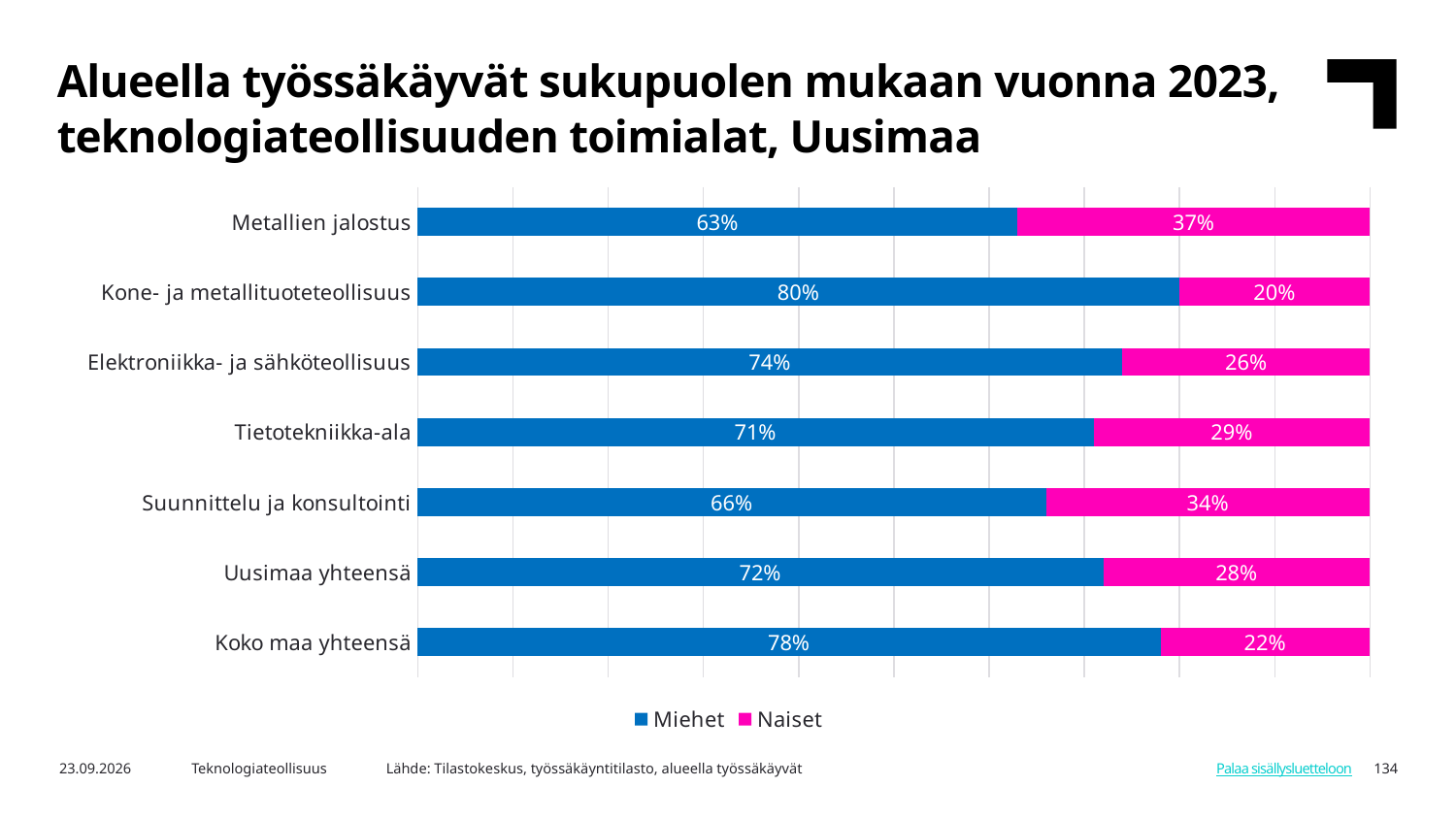
What is the Naiset share for Uusimaa yhteensä? 28% Which category has the highest Naiset share? Metallien jalostus How many categories are shown on the chart? 7 What is the Miehet share for Kone- ja metallituoteteollisuus? 80% How many series does the legend list? 2 What kind of chart is shown on the slide? Stacked bar chart Which is larger: the Naiset share for Tietotekniikka-ala or for Elektroniikka- ja sähköteollisuus? Tietotekniikka-ala What is the Naiset share for Metallien jalostus? 37% What is the difference between the Miehet share for Koko maa yhteensä and for Uusimaa yhteensä? 6 percentage points Which category has the lowest Miehet share? Metallien jalostus What is the total of the stacked bar for Suunnittelu ja konsultointi? 100% Which category has the highest Miehet share? Kone- ja metallituoteteollisuus